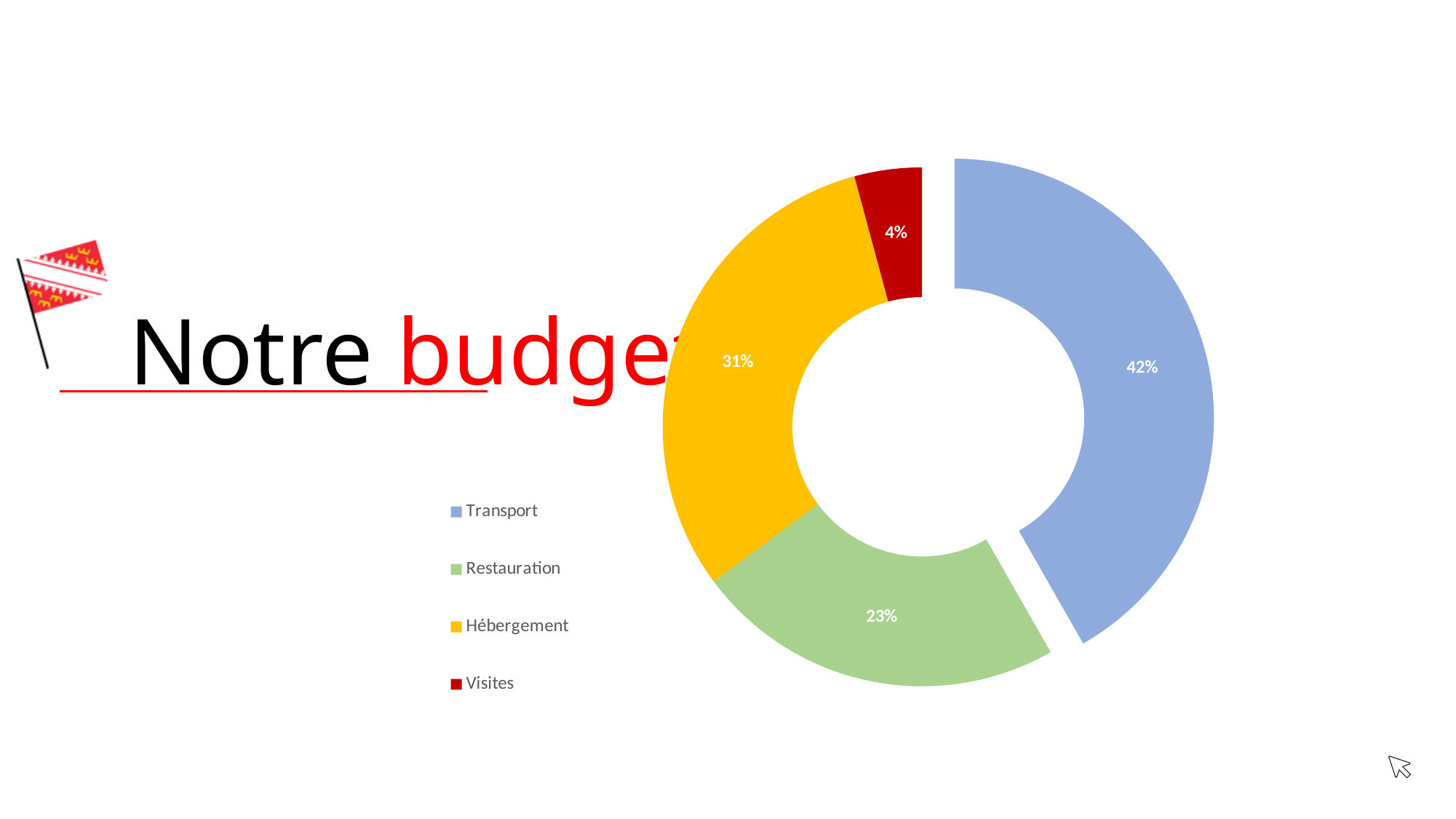
What share of the budget does Hébergement represent? 31% What is the difference in percentage points between Restauration and Visites? 19 What share of the budget does Visites represent? 4% What is the difference in percentage points between Transport and Hébergement? 11 What colour is the Visites slice in the chart? Dark red What share of the budget does Restauration represent? 23% What share of the budget does Transport represent? 42% Which is larger, the share for Hébergement or the share for Restauration? Hébergement Which category has the largest share of the budget? Transport What kind of chart is shown on the slide? Doughnut (pie) chart How many categories are shown in the chart? 4 Which category has the smallest share of the budget? Visites